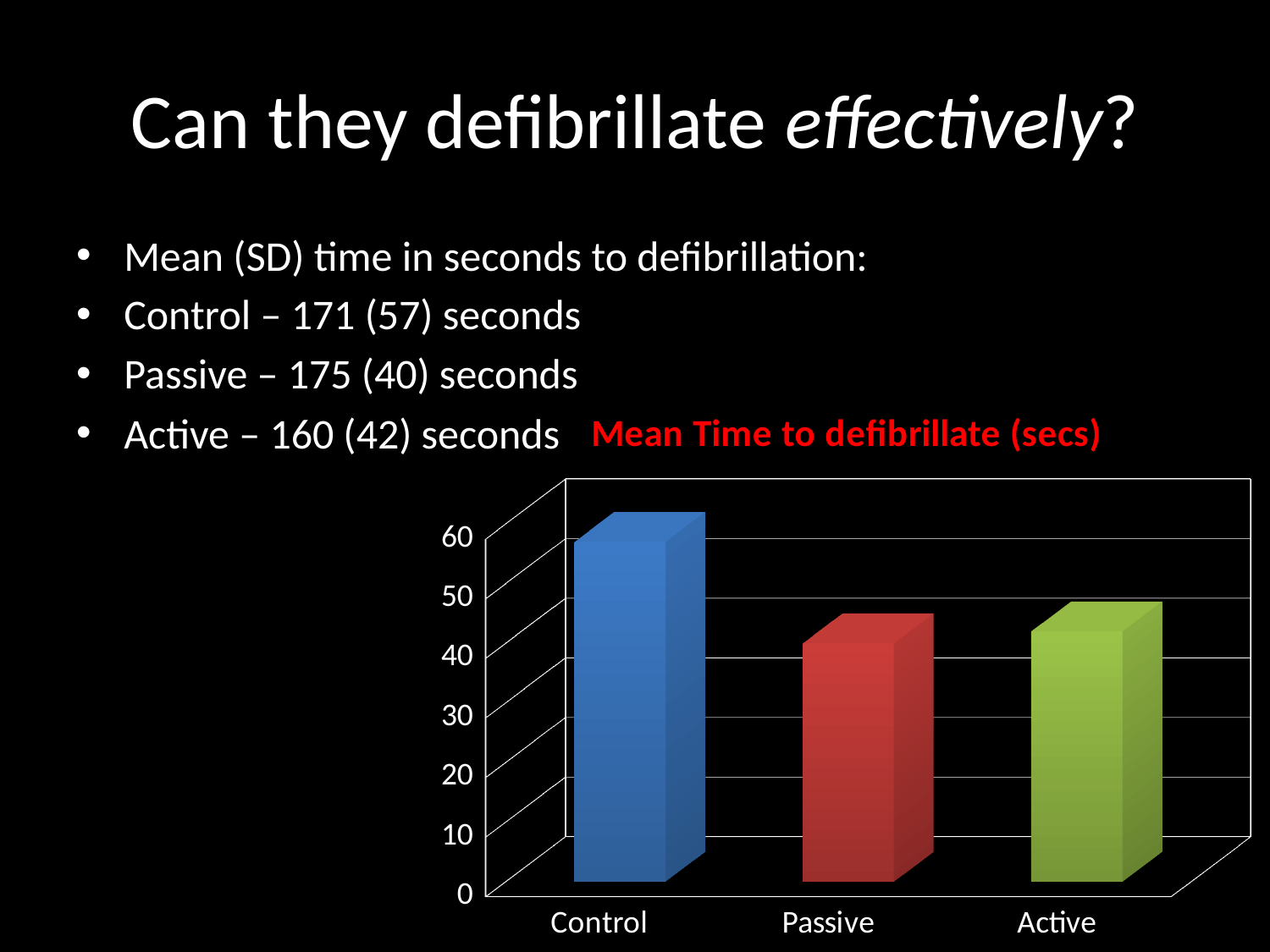
What colour is the bar for Control? blue Is the bar for Active greater or less than 50? less Which category has the tallest bar in the chart? Control Is the bar for Active greater or less than 30? greater Is the bar for Passive greater or less than 50? less What type of chart is shown on the slide? bar chart What is the title of the chart? Mean Time to defibrillate (secs) What is the highest value shown on the vertical axis of the chart? 60 How many categories are shown on the x axis of the chart? 3 Which bar is taller, Control or Active? Control Which bar is taller, Control or Passive? Control